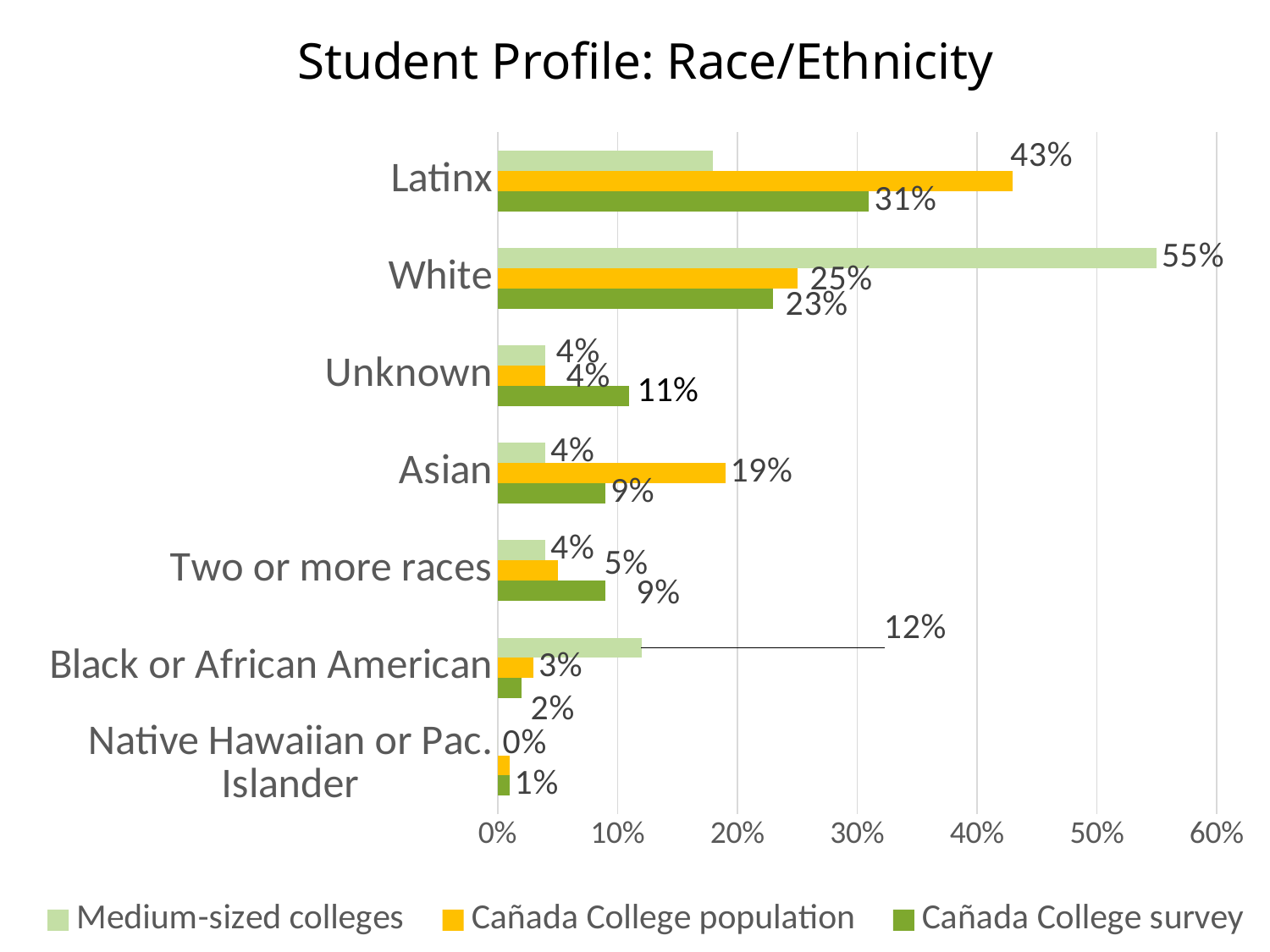
Is the Medium-sized colleges value for Latinx greater or less than 10%? greater What is the Cañada College population value for Latinx? 43% What is the Medium-sized colleges value for Black or African American? 12% What is the Cañada College survey value for Asian? 9% How many series does the legend list? 3 For Unknown, which is larger: the Cañada College survey value or the Cañada College population value? Cañada College survey What is the Medium-sized colleges value for White? 55% Which category has the highest Cañada College population value? Latinx What is the title of the chart? Student Profile: Race/Ethnicity What is the difference between the Cañada College population and Cañada College survey values for Latinx? 12 percentage points What kind of chart is shown on the slide? Bar chart How many race/ethnicity categories are plotted on the chart? 7